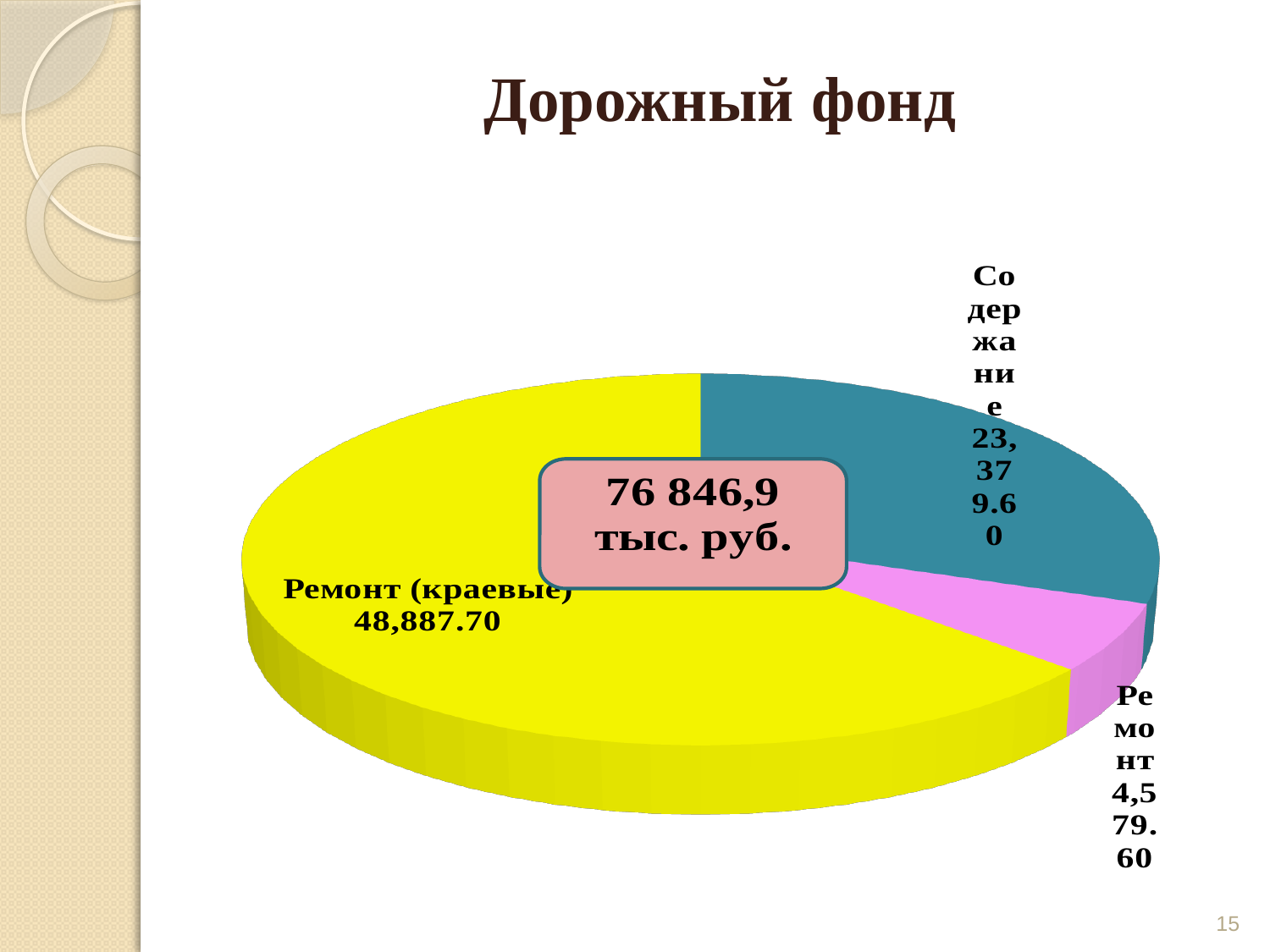
What is the value of the Содержание slice in the Дорожный фонд pie chart? 23,379.60 How many slices does the Дорожный фонд pie chart have? 3 What is the value of the Ремонт slice in the Дорожный фонд pie chart? 4,579.60 What is the value of the Ремонт (краевые) slice in the Дорожный фонд pie chart? 48,887.70 What total amount is shown in the box in the centre of the Дорожный фонд pie chart? 76 846,9 тыс. руб. What is the difference between the Содержание and Ремонт values in the Дорожный фонд pie chart? 18,800.00 What kind of chart is shown on the slide? Pie chart Which slice of the Дорожный фонд pie chart is the largest? Ремонт (краевые) Which slice of the Дорожный фонд pie chart is the smallest? Ремонт What is the difference between the Ремонт (краевые) and Содержание values in the Дорожный фонд pie chart? 25,508.10 What colour is the Ремонт (краевые) slice in the Дорожный фонд pie chart? Yellow Which is larger in the Дорожный фонд pie chart: Содержание or Ремонт? Содержание